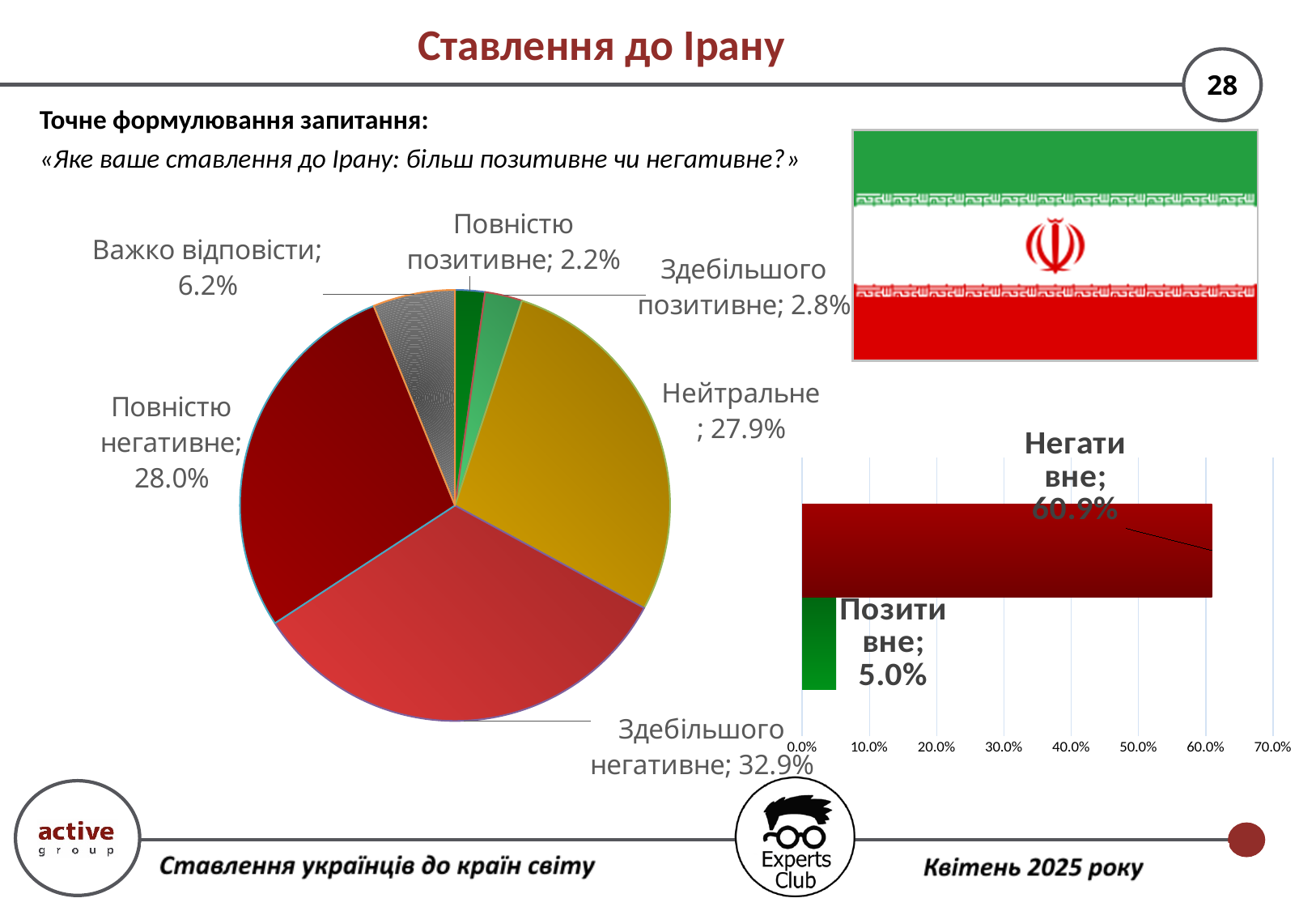
In the bar chart on the right, what is the difference between «Негативне» and «Позитивне»? 55.9% What type of chart is shown on the right side of the slide? Bar chart In the pie chart, what is the value for «Нейтральне»? 27.9% In the pie chart, what is the value for «Важко відповісти»? 6.2% In the bar chart on the right, what is the value for «Негативне»? 60.9% In the pie chart, what is the difference between «Здебільшого негативне» and «Повністю негативне»? 4.9% In the bar chart on the right, what is the value for «Позитивне»? 5.0% In the pie chart, what is the value for «Здебільшого негативне»? 32.9% How many categories does the pie chart show? 6 In the pie chart, which category has the largest share? Здебільшого негативне In the pie chart, which is larger: «Здебільшого позитивне» or «Повністю позитивне»? Здебільшого позитивне In the pie chart, which category has the smallest share? Повністю позитивне